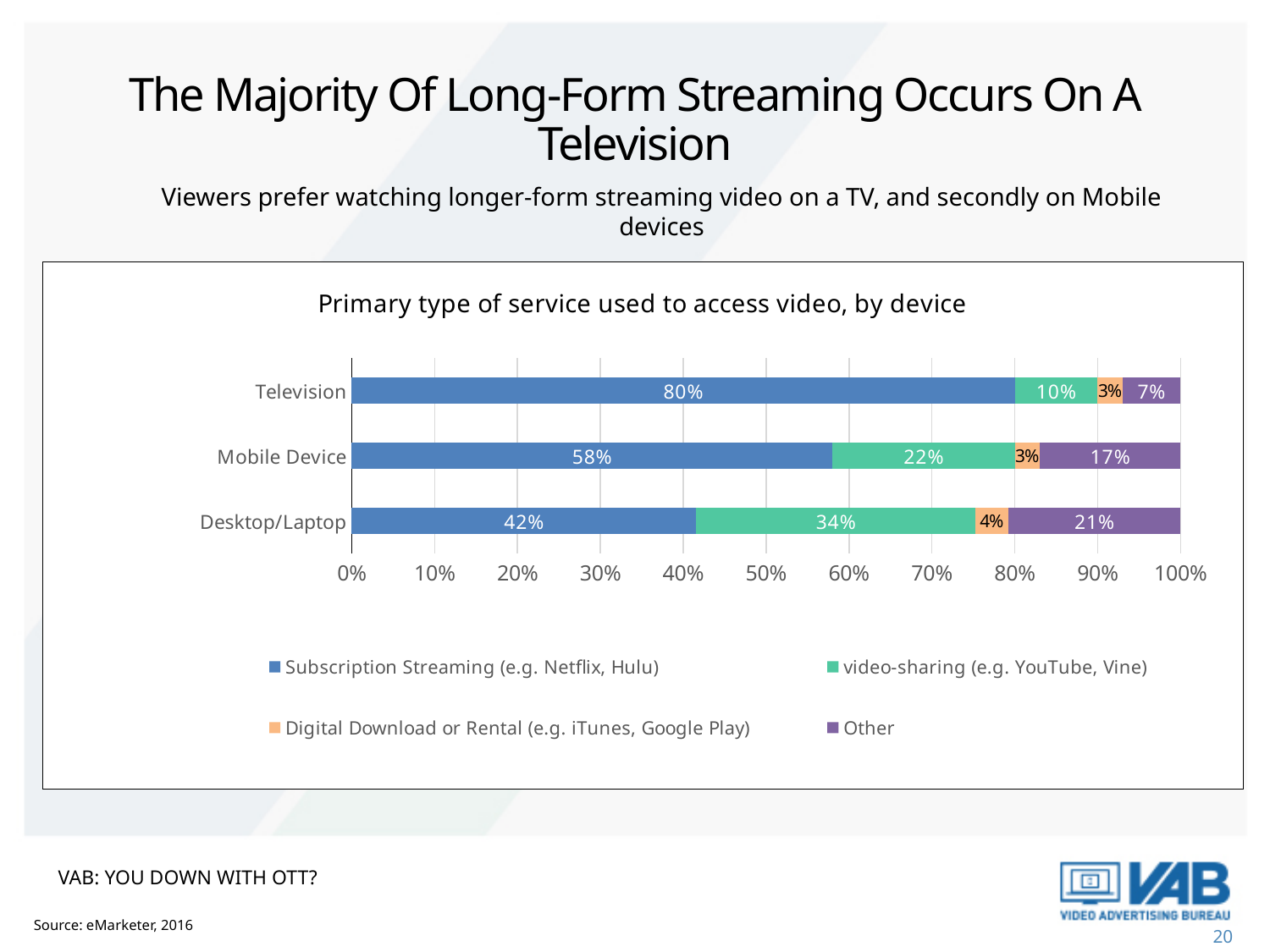
What is the video-sharing share for Mobile Device? 22% How many series does the legend list? 4 What kind of chart is shown on the slide? Stacked bar chart Which is larger: the video-sharing share for Desktop/Laptop or for Mobile Device? Desktop/Laptop What is the Digital Download or Rental share for Desktop/Laptop? 4% What is the Subscription Streaming share for Television? 80% How many device categories are shown in the chart? 3 What is the title of the chart? Primary type of service used to access video, by device Which device has the highest Subscription Streaming share? Television Which device has the lowest Other share? Television What is the Other share for Desktop/Laptop? 21% What is the difference between the Subscription Streaming shares for Television and Desktop/Laptop? 38%